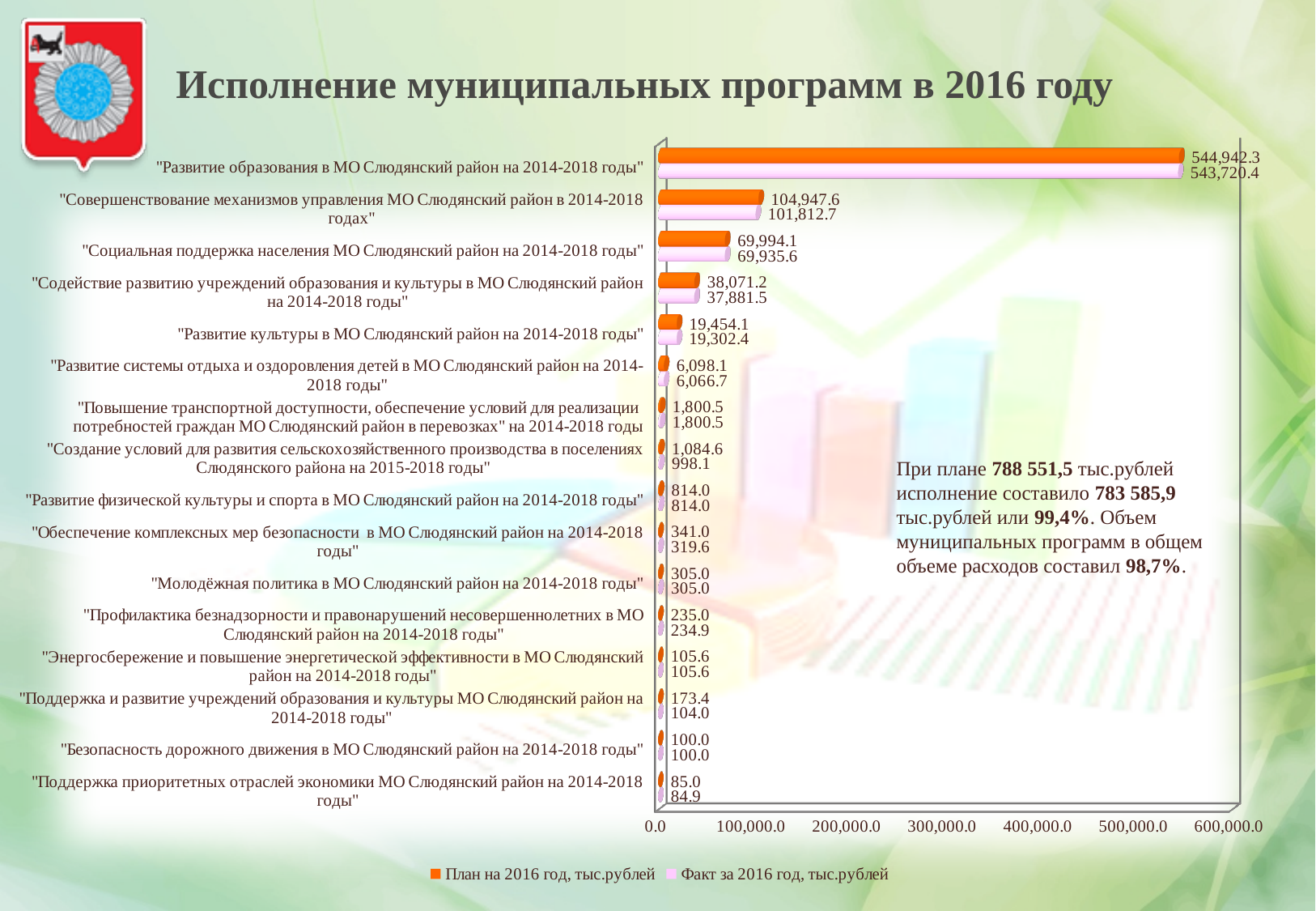
What is the value of "Факт за 2016 год, тыс.рублей" for "Совершенствование механизмов управления МО Слюдянский район в 2014-2018 годах"? 101,812.7 What is the "Факт за 2016 год" value for "Социальная поддержка населения МО Слюдянский район на 2014-2018 годы"? 69,935.6 How many municipal programs (categories) are plotted in the chart? 16 Which is larger for "Развитие культуры в МО Слюдянский район на 2014-2018 годы": the "План на 2016 год" value or the "Факт за 2016 год" value? План на 2016 год How many series does the legend list? 2 What is the title of the slide? Исполнение муниципальных программ в 2016 году What kind of chart is shown on the slide? Bar chart Which program has the lowest "Факт за 2016 год" value? "Поддержка приоритетных отраслей экономики МО Слюдянский район на 2014-2018 годы" What is the value of "План на 2016 год, тыс.рублей" for "Развитие образования в МО Слюдянский район на 2014-2018 годы"? 544,942.3 Which program has the highest "План на 2016 год" value? "Развитие образования в МО Слюдянский район на 2014-2018 годы" What is the difference between the "План" and "Факт" values for "Поддержка и развитие учреждений образования и культуры МО Слюдянский район на 2014-2018 годы"? 69.4 What is the difference between the "План" and "Факт" values for "Развитие образования в МО Слюдянский район на 2014-2018 годы"? 1,221.9